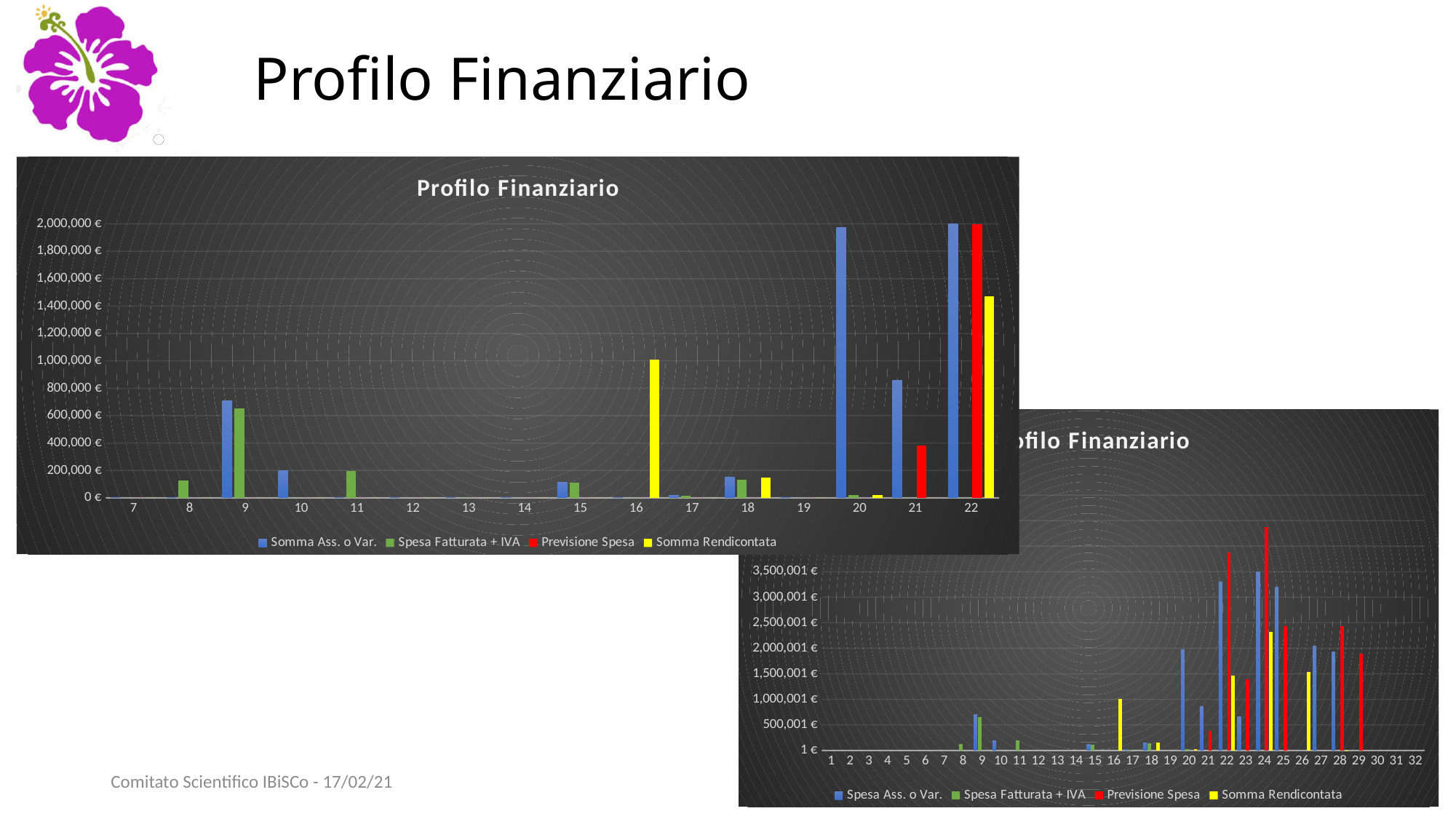
In the top-left chart, which category has the highest Somma Rendicontata bar? 22 In the bottom-right chart, is the Previsione Spesa value for category 24 greater or less than 3,500,001 €? greater In the top-left chart, is the Somma Rendicontata value for category 16 greater or less than 800,000 €? greater In the top-left chart, is the Somma Rendicontata value for category 22 greater or less than 1,600,000 €? less How many categories are shown on the x axis of the bottom-right chart? 32 What type of chart is the top-left chart on the slide? bar chart How many categories are shown on the x axis of the top-left chart? 16 What is the name of the first series in the legend of the bottom-right chart? Spesa Ass. o Var. In the bottom-right chart, which category has the highest Previsione Spesa bar? 24 How many series does the legend of the top-left chart list? 4